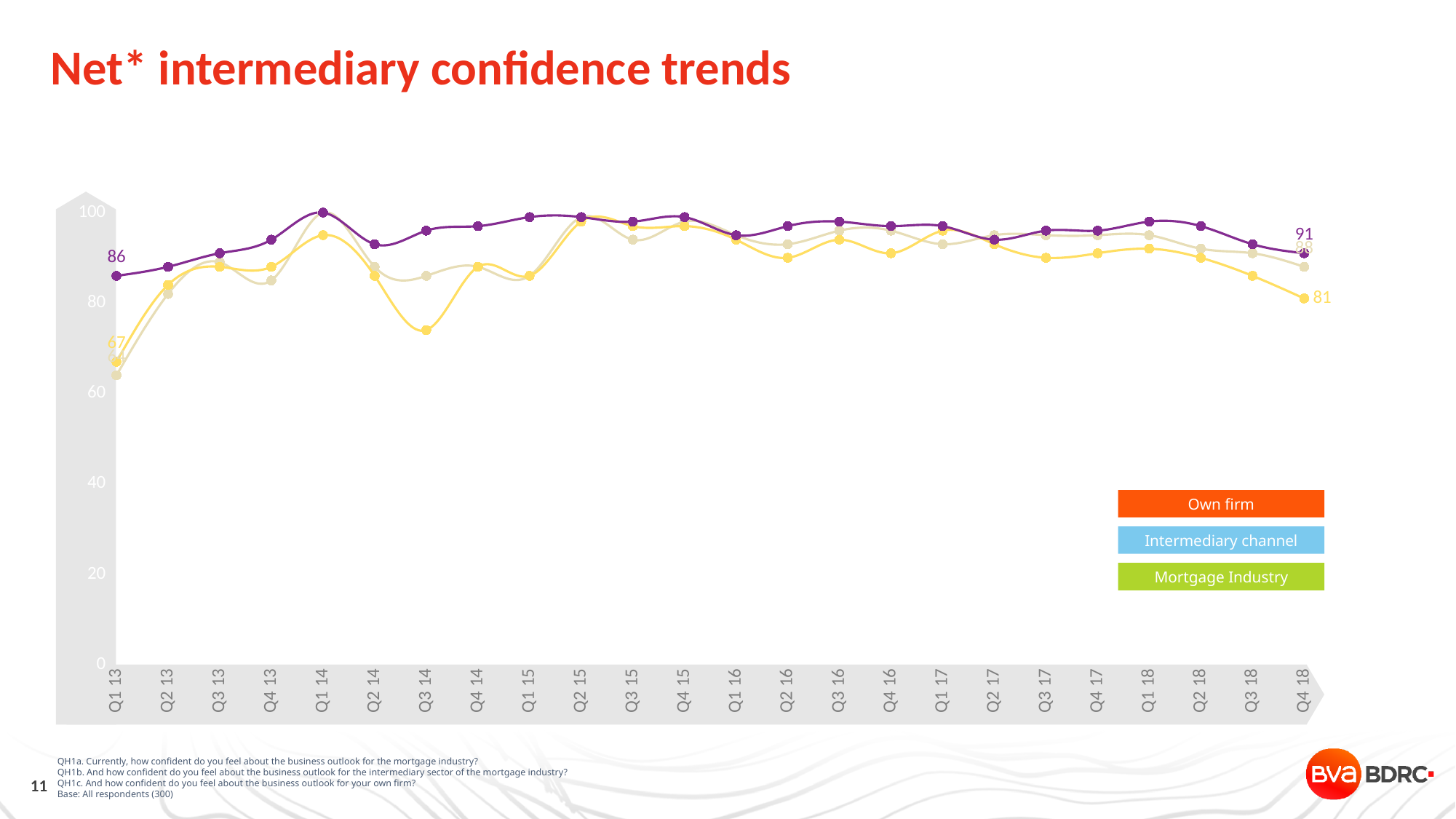
What is the value of the yellow line at Q4 18? 81 At which quarter is the yellow line at its lowest? Q1 13 Is the value of the yellow line at Q3 14 greater or less than 80? less What is the value of the yellow line at Q1 13? 67 What is the value of the purple line at Q4 18? 91 At Q1 13, which is higher: the purple line or the yellow line? the purple line What kind of chart is shown on the slide? line chart What is the difference between the purple line (91) and the yellow line (81) at Q4 18? 10 By how much did the purple line change from Q1 13 (86) to Q4 18 (91)? 5 What is the value of the purple line at Q1 13? 86 How many series does the legend list? 3 How many quarters are shown along the x axis? 24